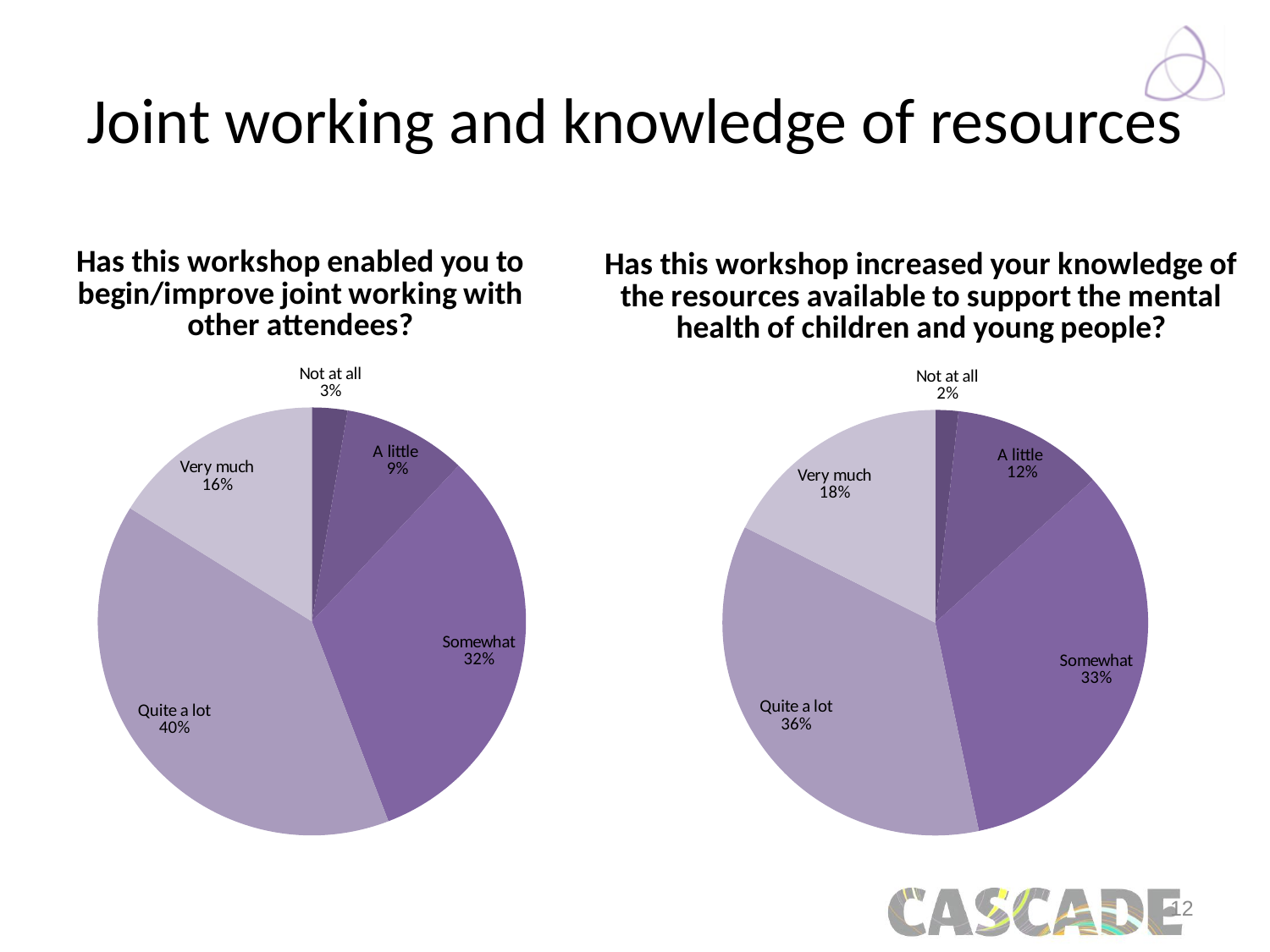
In the left pie chart (joint working with other attendees), which response has the largest share? Quite a lot What is the title of the right pie chart? Has this workshop increased your knowledge of the resources available to support the mental health of children and young people? What type of chart is used on this slide? Pie chart In the left pie chart (joint working with other attendees), what is the combined share of 'Quite a lot' and 'Very much'? 56% Which is larger in the right pie chart (knowledge of resources): the 'Quite a lot' share or the 'Somewhat' share? Quite a lot In the left pie chart (joint working with other attendees), what is the difference between the 'Quite a lot' and 'Somewhat' shares? 8% In the right pie chart (knowledge of resources), which response has the smallest share? Not at all Is the 'Very much' share larger in the left pie chart (joint working) or the right pie chart (knowledge of resources)? Right pie chart (knowledge of resources) How many response categories are shown in the left pie chart (joint working with other attendees)? 5 In the right pie chart (knowledge of resources), what share of respondents answered 'Somewhat'? 33% In the left pie chart (joint working with other attendees), what share of respondents answered 'Quite a lot'? 40% In the right pie chart (knowledge of resources), what is the difference between the 'Very much' and 'A little' shares? 6%